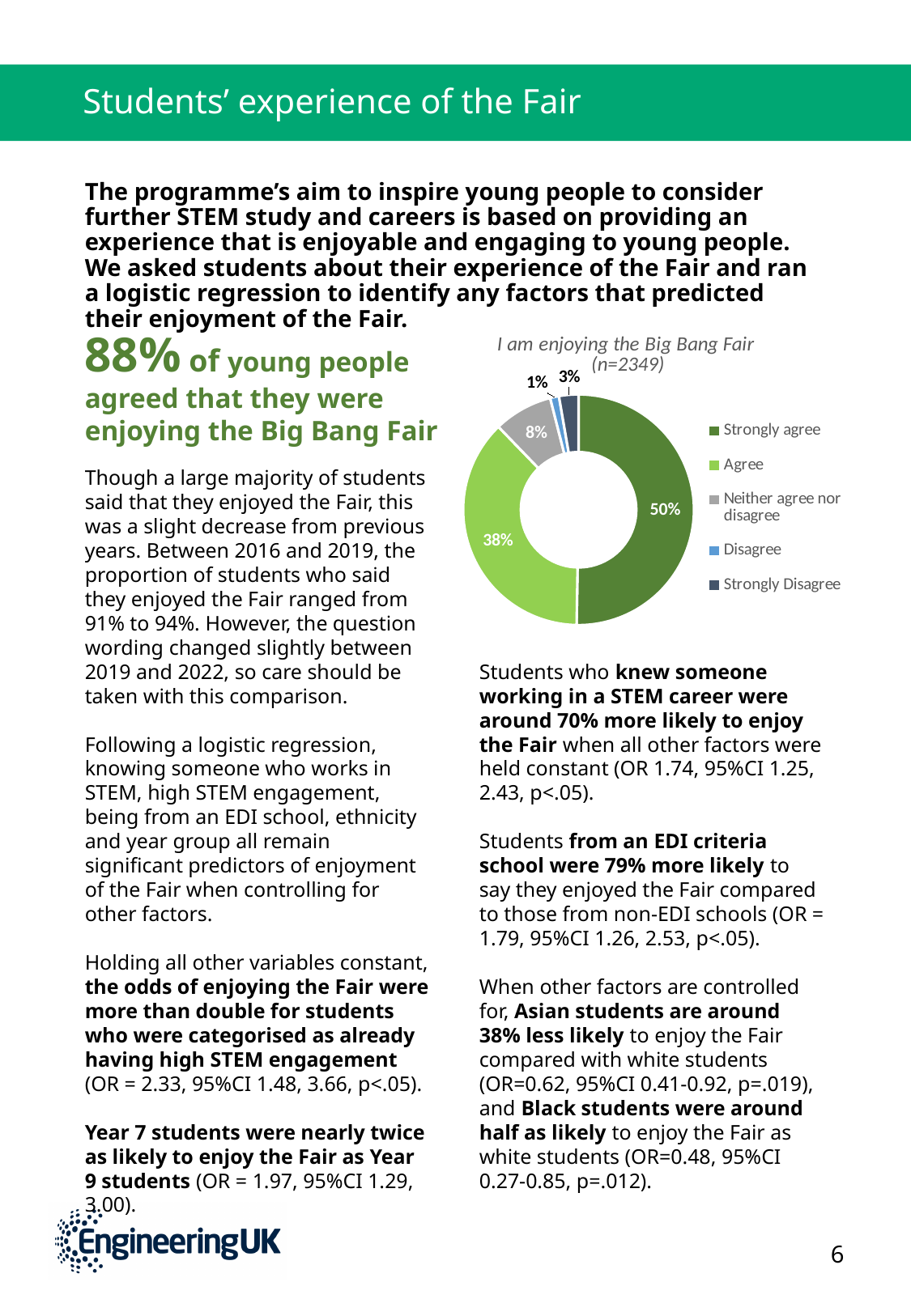
What percentage of students answered 'Agree' in the chart? 38% What is the difference in percentage points between 'Strongly agree' and 'Agree'? 12 percentage points What type of chart is shown on the slide? Pie chart (doughnut) Which response category has the largest share of the chart? Strongly agree What percentage of students answered 'Neither agree nor disagree'? 8% What percentage of students strongly agreed that they were enjoying the Big Bang Fair? 50% Which response category has the smallest share of the chart? Disagree What percentage of students answered 'Disagree'? 1% How many response categories does the chart's legend list? 5 What is the sample size (n) given in the chart title? 2349 What percentage of students answered 'Strongly Disagree'? 3% Which is larger, the share for 'Neither agree nor disagree' or the share for 'Strongly Disagree'? Neither agree nor disagree